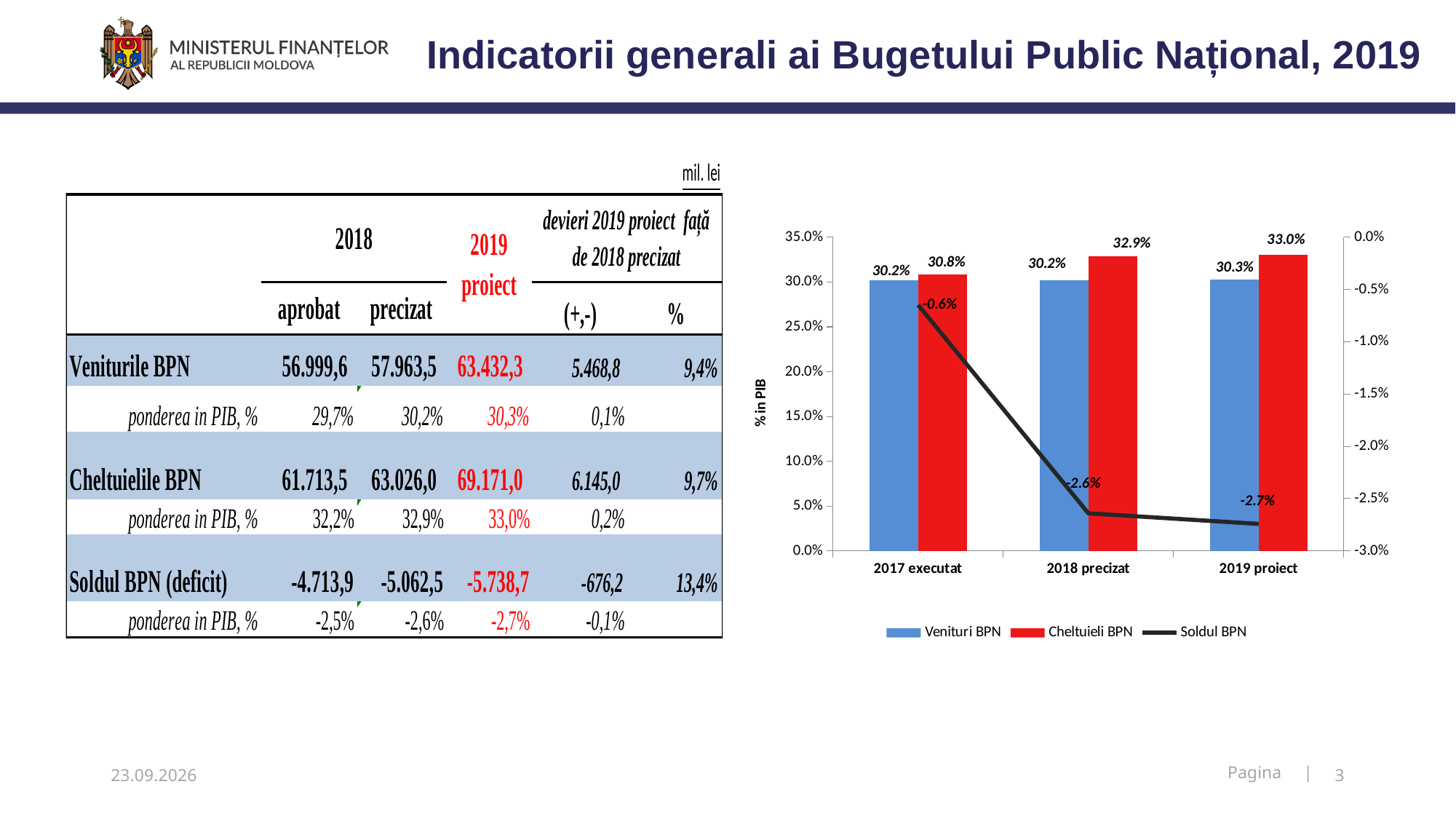
In which category is Cheltuieli BPN highest in the chart? 2019 proiect What is the value of Venituri BPN for 2019 proiect in the chart? 30.3% What is the value of Soldul BPN for 2017 executat in the chart? -0.6% Does Soldul BPN rise or fall from 2017 executat to 2019 proiect in the chart? fall How many series does the chart legend list? 3 How many categories are shown on the x axis of the chart? 3 What is the label of the left vertical axis of the chart? % in PIB What is the value of Cheltuieli BPN for 2017 executat in the chart? 30.8% Which is larger for 2018 precizat in the chart: Venituri BPN or Cheltuieli BPN? Cheltuieli BPN In which category is Soldul BPN lowest in the chart? 2019 proiect What is the value of Cheltuieli BPN for 2018 precizat in the chart? 32.9% What is the difference between Cheltuieli BPN and Venituri BPN for 2019 proiect in the chart? 2.7%